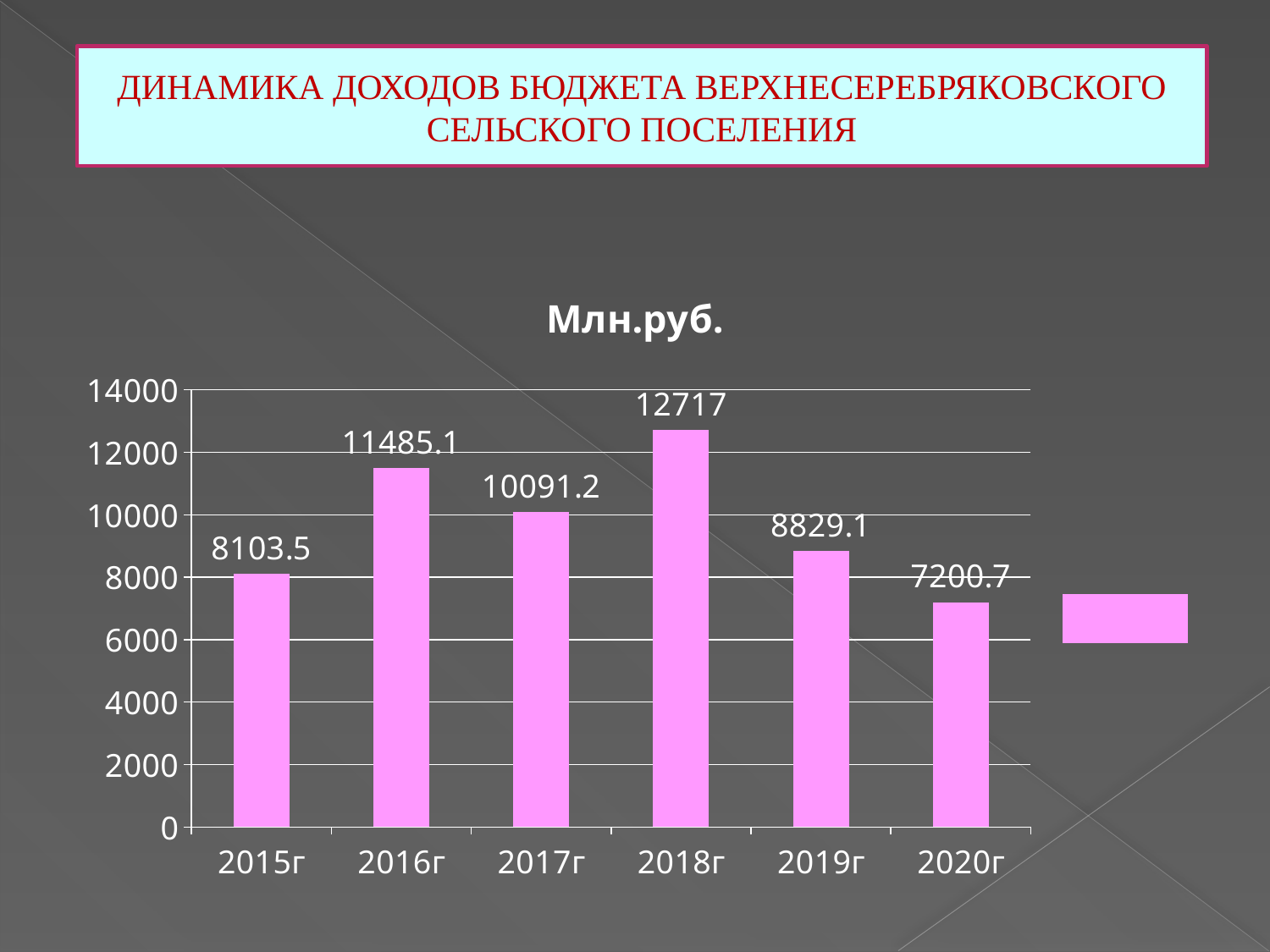
What kind of chart is shown on the slide? bar chart What is the difference between the values for 2018г and 2019г? 3887.9 Do the values rise or fall from 2018г to 2020г? fall What is the title of the chart? Млн.руб. What is the value for 2018г? 12717 What is the value for 2020г? 7200.7 What is the value for 2015г? 8103.5 Which is larger, the value for 2016г or the value for 2017г? 2016г Which year has the lowest value? 2020г Is the value for 2019г greater or less than 10000? less Which year has the highest value? 2018г How many years are shown on the x axis? 6